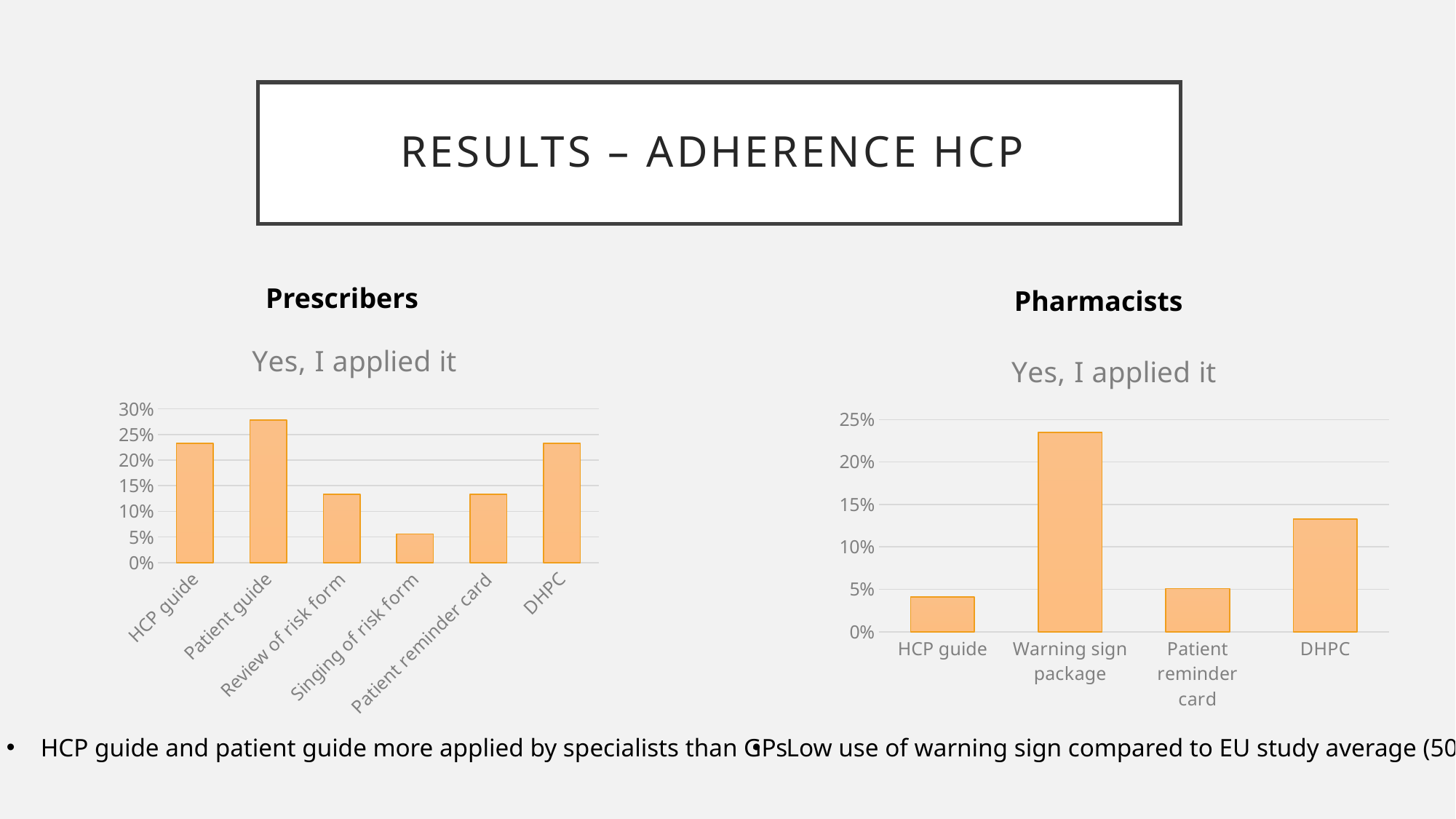
What type of chart is the Pharmacists chart? bar chart How many categories are shown in the Prescribers chart? 6 In the Prescribers chart, which category has the highest value? Patient guide In the Prescribers chart, which category has the lowest value? Singing of risk form In the Prescribers chart, is the value for Singing of risk form greater or less than 10%? less In the Pharmacists chart, which category has the highest value? Warning sign package How many categories are shown in the Pharmacists chart? 4 In the Prescribers chart, which is larger, the value for Patient guide or the value for Review of risk form? Patient guide In the Pharmacists chart, which is larger, the value for DHPC or the value for HCP guide? DHPC In the Pharmacists chart, is the value for Warning sign package greater or less than 20%? greater In the Pharmacists chart, is the value for DHPC greater or less than 10%? greater